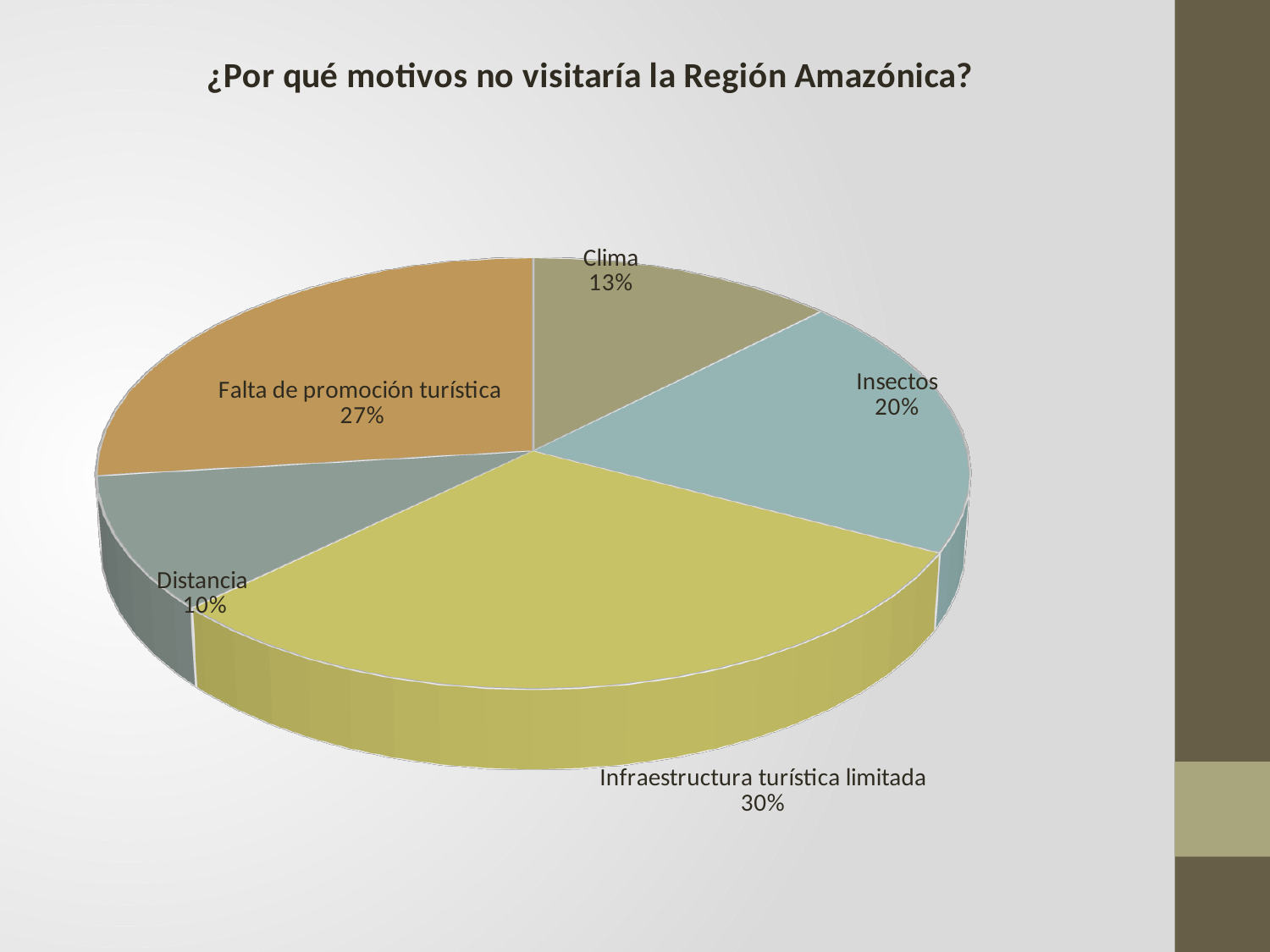
What percentage is shown for Distancia? 10% What is the title of the chart? ¿Por qué motivos no visitaría la Región Amazónica? What is the difference in percentage points between Infraestructura turística limitada and Clima? 17 What type of chart is shown on the slide? Pie chart Which category has the smallest share of the pie? Distancia Which category has the largest share of the pie? Infraestructura turística limitada Which is larger, the share for Insectos or the share for Distancia? Insectos What percentage is shown for Infraestructura turística limitada? 30% What percentage is shown for Insectos? 20% What percentage is shown for Falta de promoción turística? 27% What percentage is shown for Clima? 13% How many categories are shown in the pie chart? 5